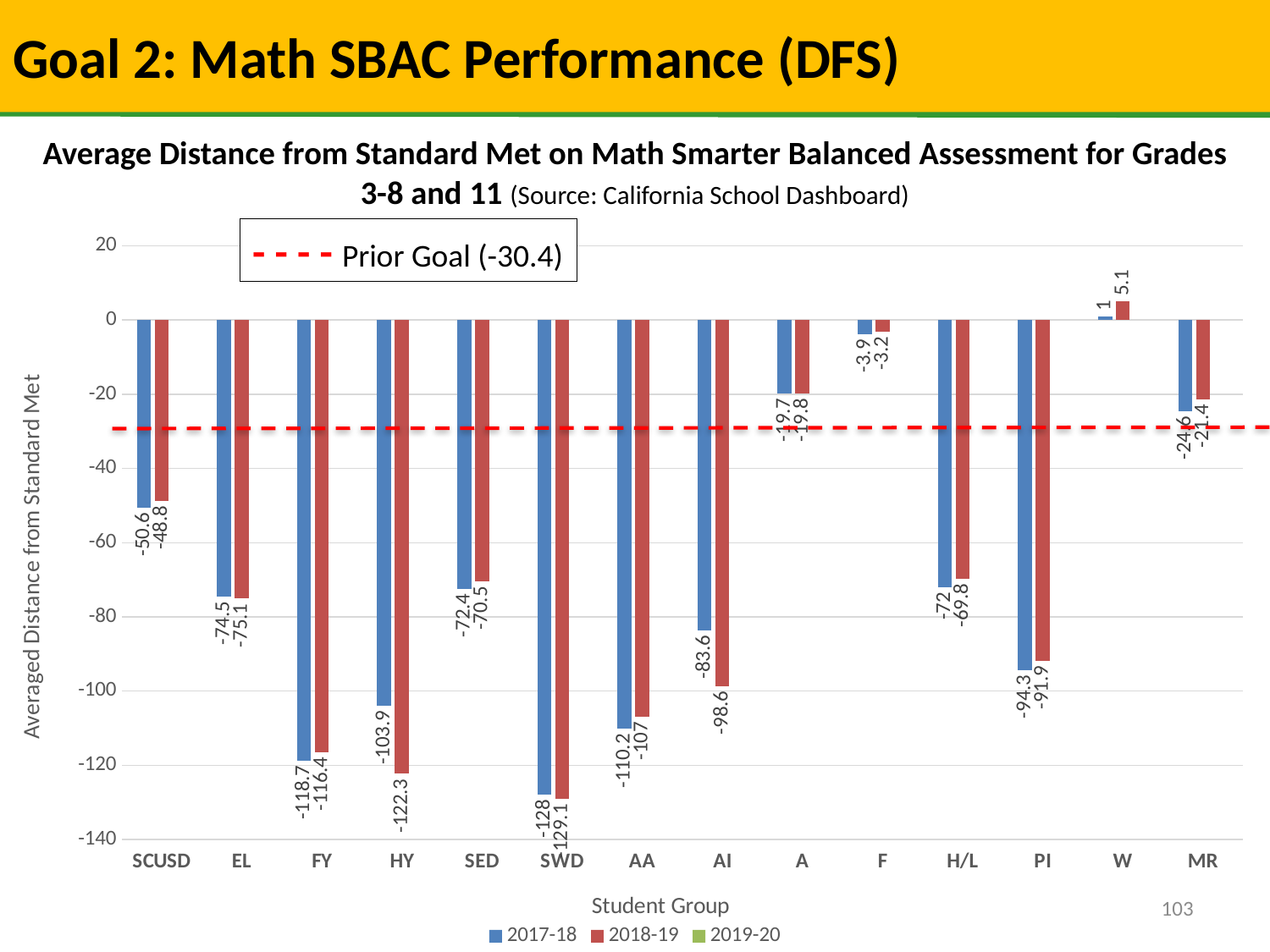
What is the 2018-19 value for W? 5.1 How many series does the legend list? 3 What is the difference between the 2017-18 and 2018-19 values for HY? 18.4 What is the 2017-18 value for HY? -103.9 How many student groups are shown on the x axis? 14 What kind of chart is this? Bar chart Which student group has the highest 2017-18 value? W Which student group has the lowest 2018-19 value? SWD Which is larger, the 2018-19 value for SCUSD or the 2018-19 value for EL? SCUSD What is the difference between the 2017-18 and 2018-19 values for AI? 15 What is the 2018-19 value for SWD? -129.1 What value does the dashed red line labelled Prior Goal represent? -30.4